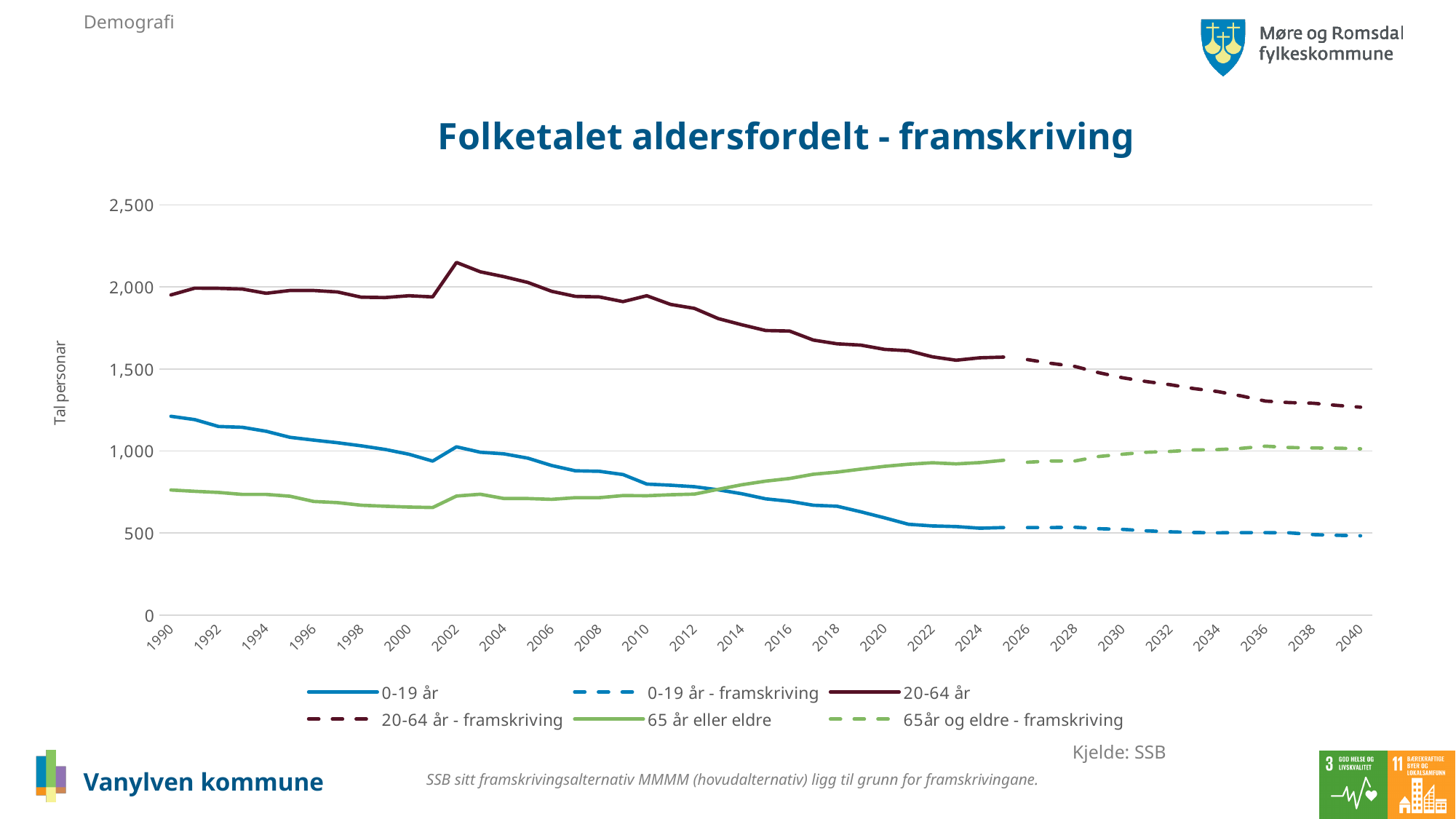
Does the 65 år eller eldre series rise or fall between 2010 and 2024? rise What kind of chart is shown on the slide? line chart Which series has the lowest value in 1990? 65 år eller eldre Which series has the highest value in 1990? 20-64 år How many series does the legend list? 6 Is the value for 20-64 år - framskriving in 2040 greater or less than 1,500? less In 2040, which is larger: 65år og eldre - framskriving or 0-19 år - framskriving? 65år og eldre - framskriving Is the value for 0-19 år in 1990 greater or less than 1,000? greater What is the title of the chart? Folketalet aldersfordelt - framskriving Is the value for 20-64 år in 2002 greater or less than 2,000? greater What is the label on the vertical axis? Tal personar Does the 20-64 år series rise or fall between 2002 and 2024? fall